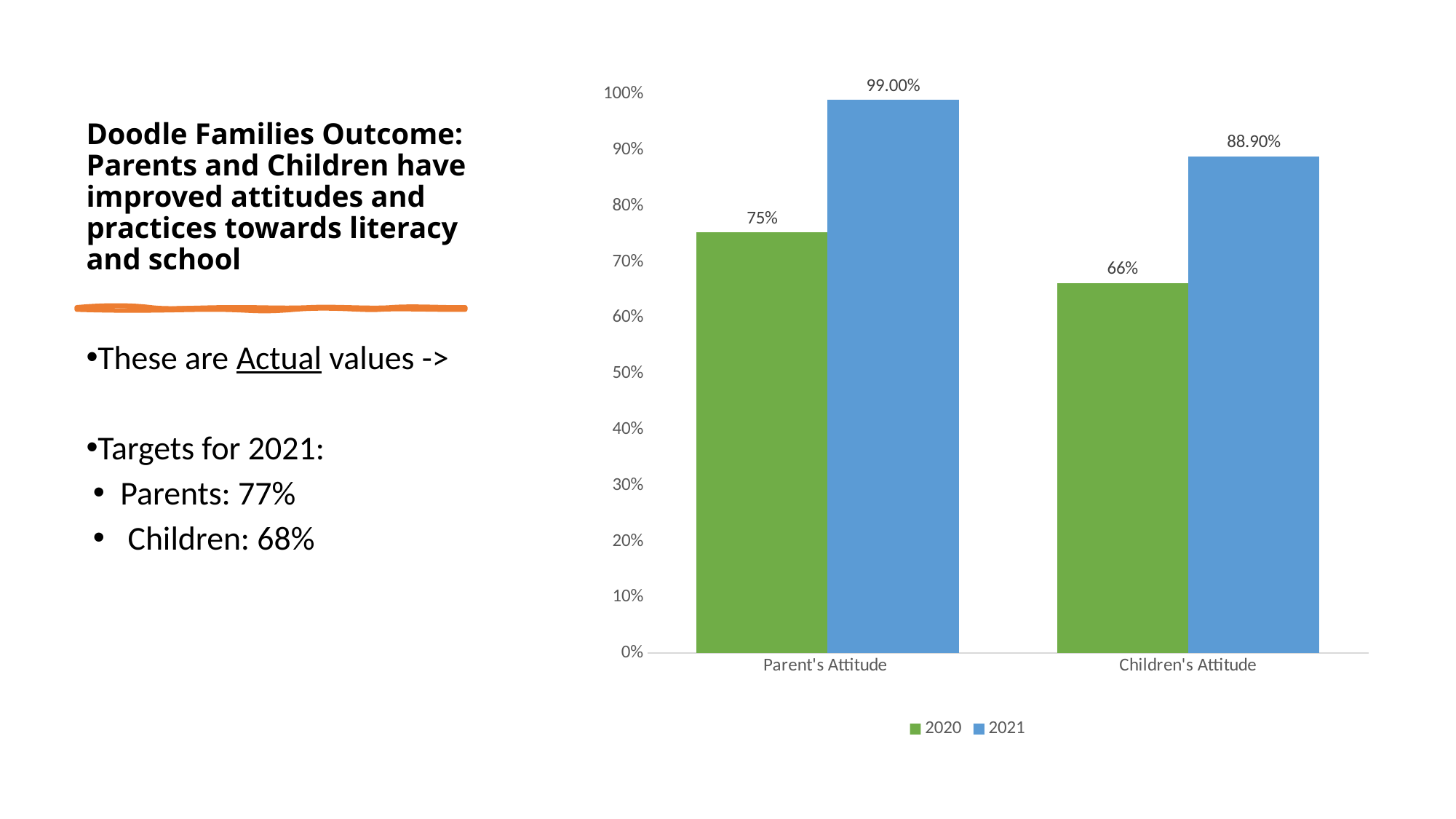
What kind of chart is shown on the slide? Bar chart How many series does the legend list? 2 What is the difference between the 2020 values for Parent's Attitude and Children's Attitude? 9% What is the 2021 value for Children's Attitude? 88.90% How many categories are shown on the x axis? 2 What is the 2020 value for Children's Attitude? 66% Is the 2021 value for Children's Attitude greater or less than 80%? greater For Children's Attitude, which series is larger, 2020 or 2021? 2021 Which category has the highest 2021 value? Parent's Attitude What is the 2021 value for Parent's Attitude? 99.00% Which category has the lowest 2020 value? Children's Attitude What is the 2020 value for Parent's Attitude? 75%